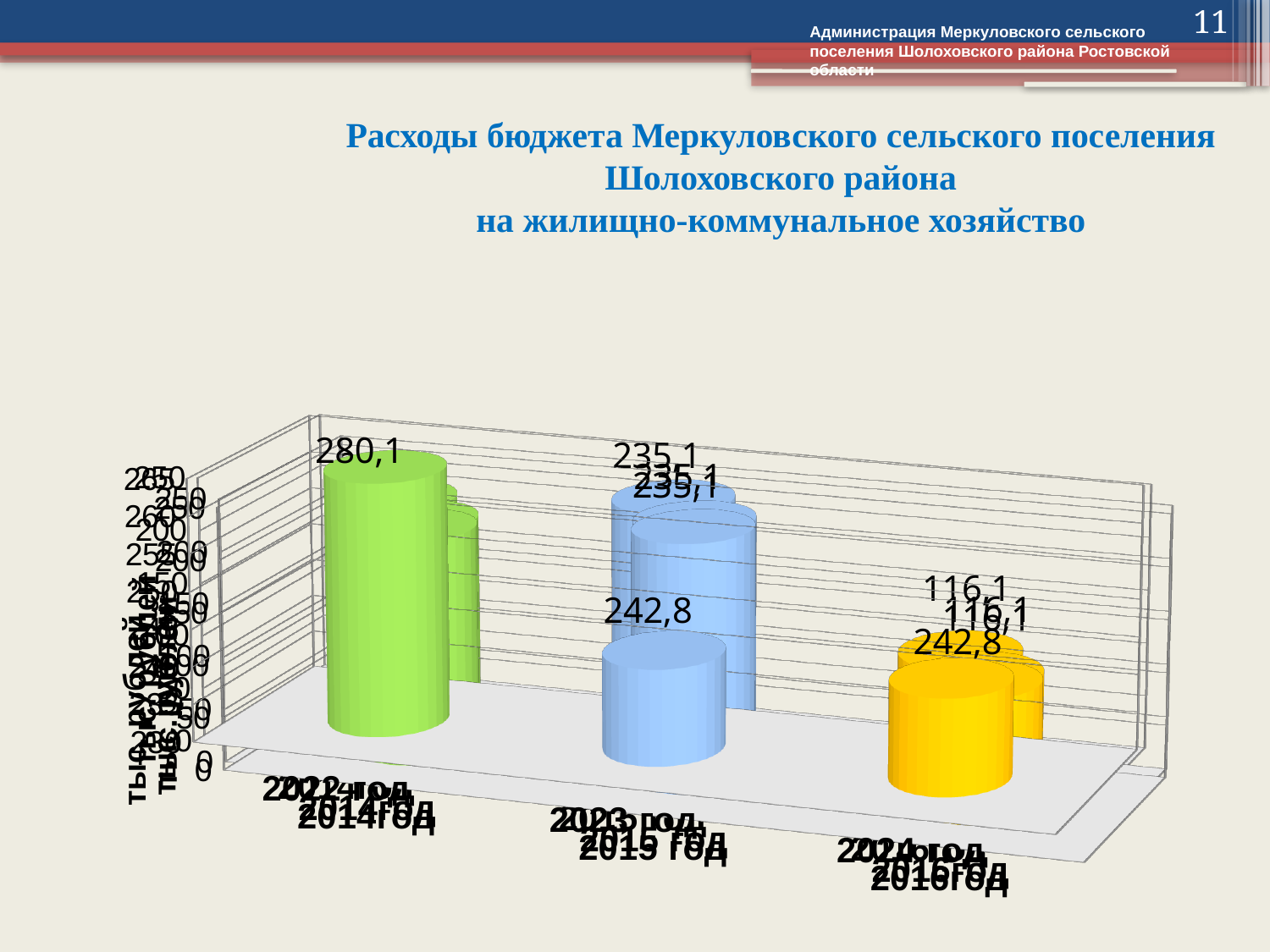
What colour is the tallest cylinder in the chart? green Is the value labelled 116,1 greater or less than 150? less What is the largest data label value printed on the chart? 280,1 What kind of chart is shown on the slide? bar chart What is the smallest data label value printed on the chart? 116,1 Which is larger, the value labelled 280,1 or the value labelled 242,8? 280,1 What is the title of the chart on the slide? Расходы бюджета Меркуловского сельского поселения Шолоховского района на жилищно-коммунальное хозяйство Is the value labelled 280,1 greater or less than 250? greater